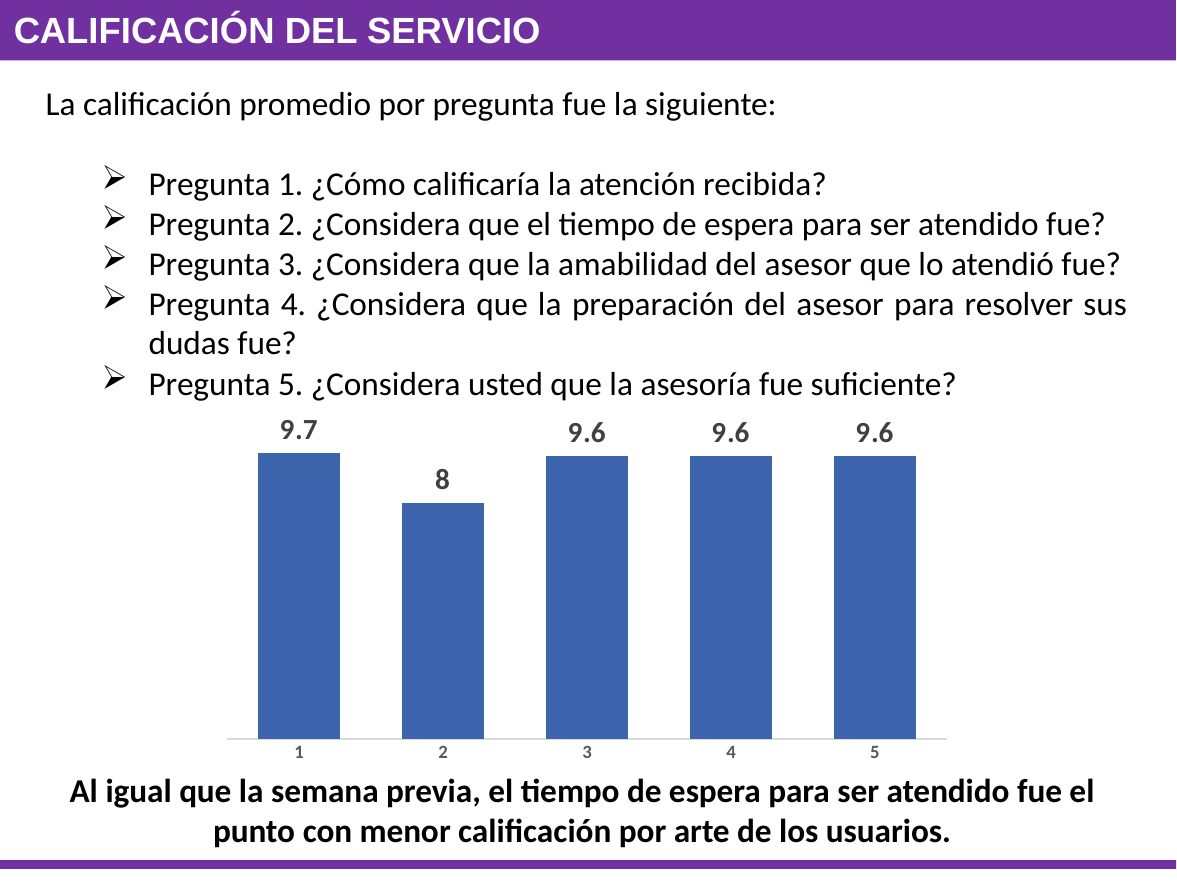
How many categories are shown on the x axis? 5 What is the difference between the values for category 1 and category 2? 1.7 What is the difference between the values for category 1 and category 4? 0.1 What is the value for category 1? 9.7 Which category has the lowest value? 2 Which is larger, the value for category 2 or the value for category 4? 4 Which category has the highest value? 1 What is the value for category 5? 9.6 What is the value for category 3? 9.6 What kind of chart is shown on the slide? bar chart What is the value for category 2? 8 How many categories have a value of 9.6? 3